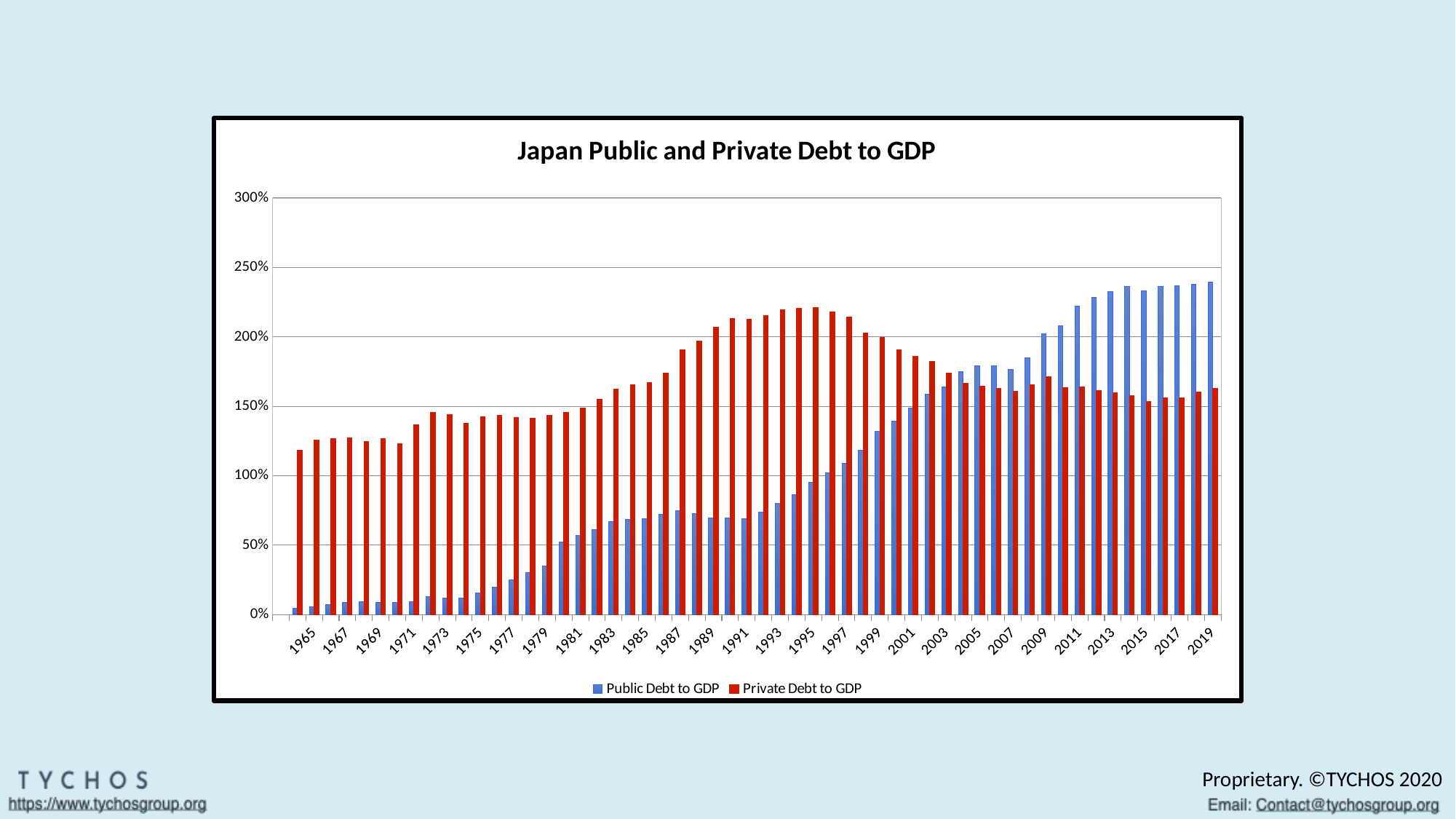
What type of chart is shown on the slide? Bar chart Is the value for Public Debt to GDP in 1965 greater or less than 50%? less Is the value for Public Debt to GDP in 2019 greater or less than 200%? greater In 2019, which is larger: Public Debt to GDP or Private Debt to GDP? Public Debt to GDP Which colour represents Private Debt to GDP in the chart? Red What is the title of the chart? Japan Public and Private Debt to GDP In 1965, which is larger: Public Debt to GDP or Private Debt to GDP? Private Debt to GDP Is the value for Private Debt to GDP in 1965 greater or less than 100%? greater How many series does the legend list? 2 Does Public Debt to GDP generally rise or fall from 1965 to 2019? Rise